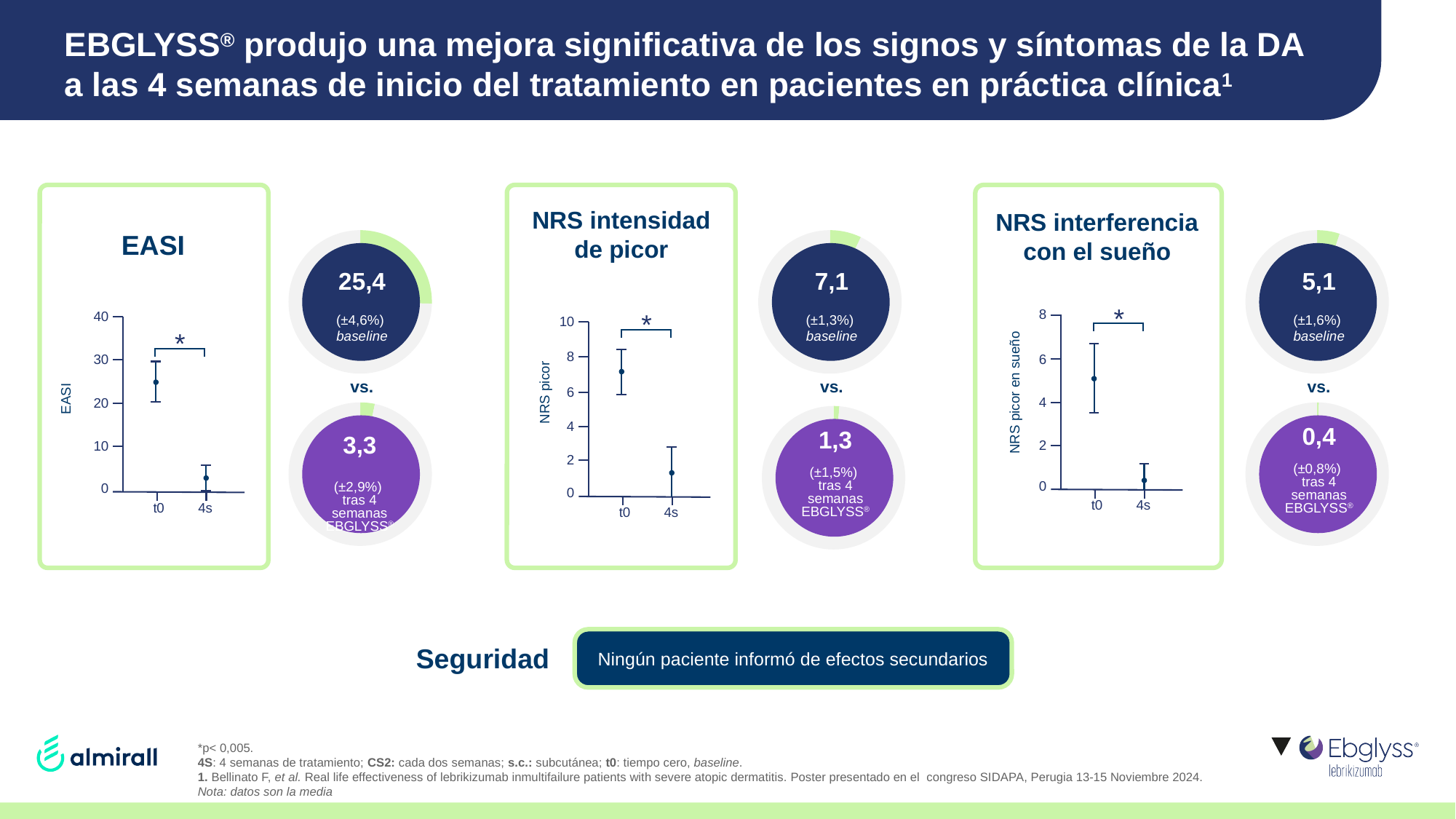
In the NRS intensidad de picor chart, what is the difference between the t0 and 4s mean values? 5,8 How many time points are plotted on the x axis of the NRS interferencia con el sueño chart? 2 In the EASI chart, by how much does the mean EASI value fall from t0 to 4s? 22,1 What is the maximum value shown on the y axis of the NRS intensidad de picor chart? 10 In the EASI chart, what is the mean EASI value at baseline (t0)? 25,4 In the EASI chart, what is the mean EASI value after 4 weeks of EBGLYSS (4s)? 3,3 In the NRS intensidad de picor chart, what is the mean value at baseline (t0)? 7,1 In the NRS intensidad de picor chart, is the mean value at 4s greater or less than 2? less In the NRS interferencia con el sueño chart, which time point has the higher mean value, t0 or 4s? t0 In the EASI chart, do the values rise or fall from t0 to 4s? fall In the NRS interferencia con el sueño chart, what is the mean value after 4 weeks (4s)? 0,4 In the EASI chart, is the mean value at t0 greater or less than 20? greater